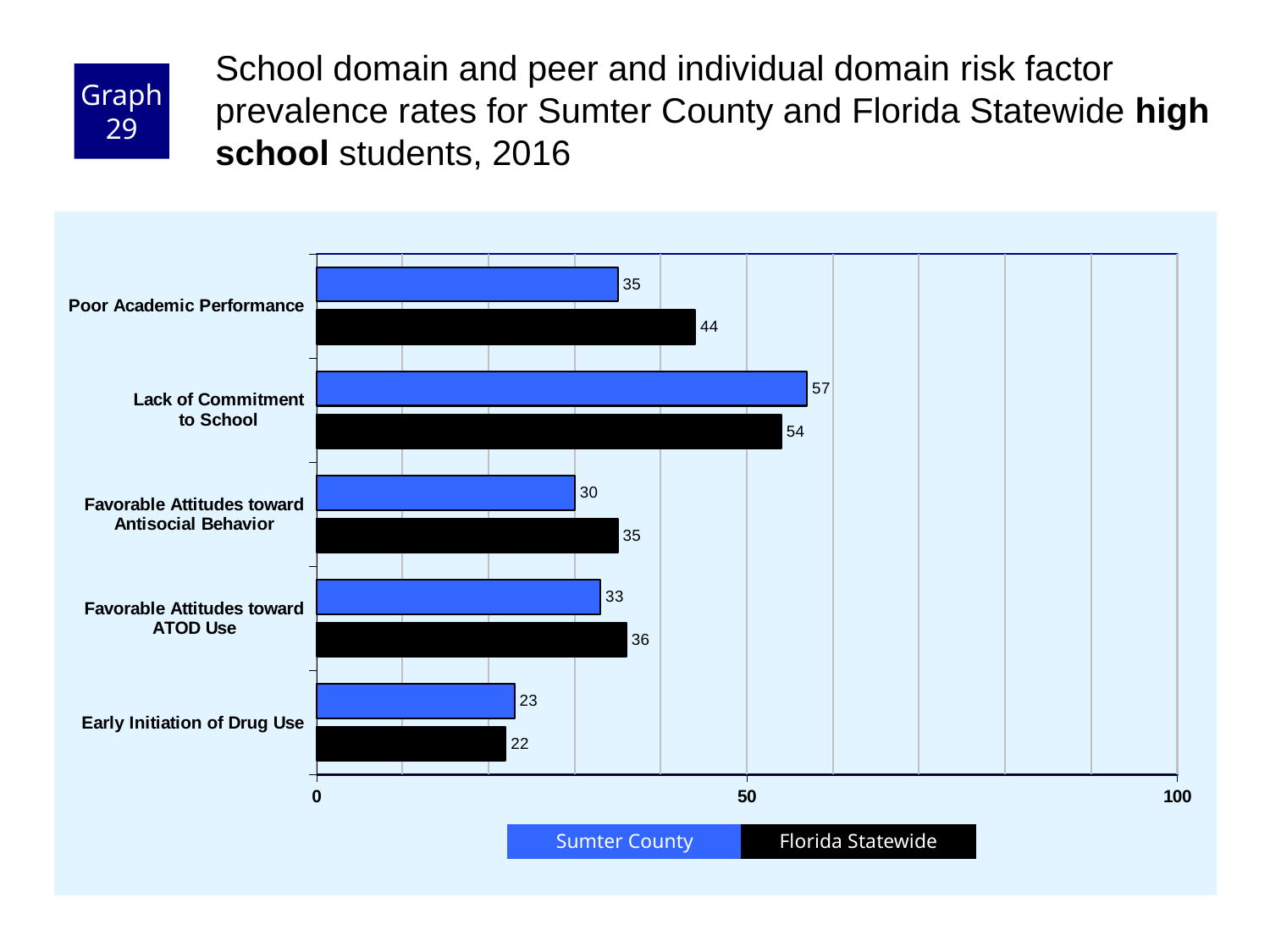
Is the Sumter County value for Lack of Commitment to School greater or less than 50? greater Which risk factor has the highest Sumter County value? Lack of Commitment to School Which colour represents Florida Statewide in the chart? Black What kind of chart is shown on the slide? Bar chart What is the Sumter County value for Early Initiation of Drug Use? 23 What is the difference between the Florida Statewide and Sumter County values for Poor Academic Performance? 9 How many risk factor categories are shown on the chart? 5 Which risk factor has the lowest Florida Statewide value? Early Initiation of Drug Use What is the Florida Statewide value for Lack of Commitment to School? 54 How many series does the legend list? 2 For Favorable Attitudes toward ATOD Use, which is larger: the Sumter County value or the Florida Statewide value? Florida Statewide What is the Sumter County value for Poor Academic Performance? 35